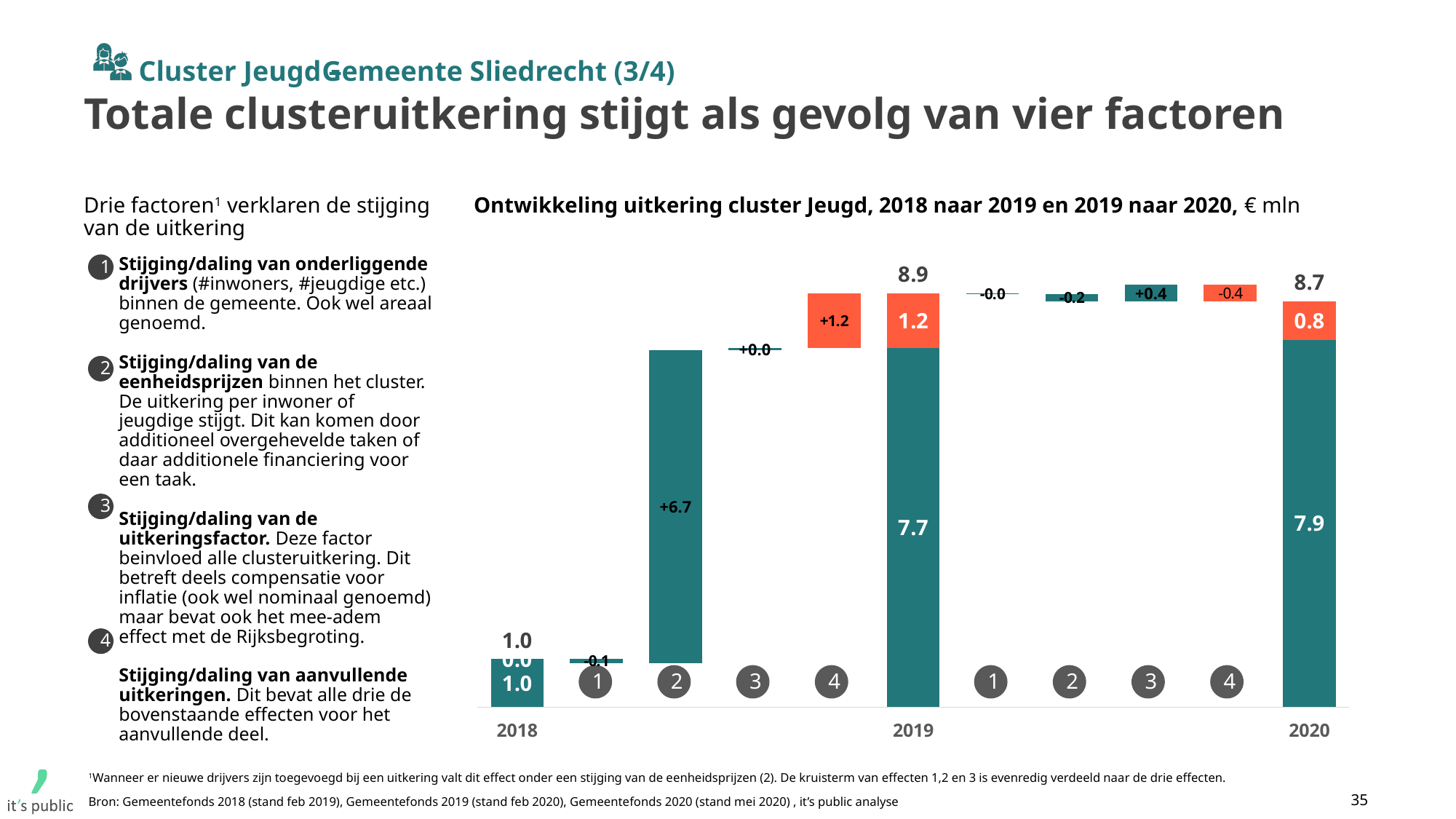
What is the effect of factor 4 on the uitkering from 2019 to 2020? -0.4 What is the effect of factor 2 on the uitkering from 2018 to 2019? +6.7 What kind of chart is shown on the slide? Bar chart (waterfall) What is the effect of factor 3 on the uitkering from 2019 to 2020? +0.4 What is the difference between the total uitkering in 2019 and in 2020? 0.2 Which factor has the largest effect on the uitkering from 2018 to 2019? Factor 2 What is the total uitkering for cluster Jeugd in 2020 according to the chart? 8.7 Which year has the highest total uitkering in the chart? 2019 What is the effect of factor 4 on the uitkering from 2018 to 2019? +1.2 What is the total uitkering for cluster Jeugd in 2019 according to the chart? 8.9 What is the teal (lower) portion of the 2020 bar? 7.9 What is the total uitkering for cluster Jeugd in 2018 according to the chart? 1.0